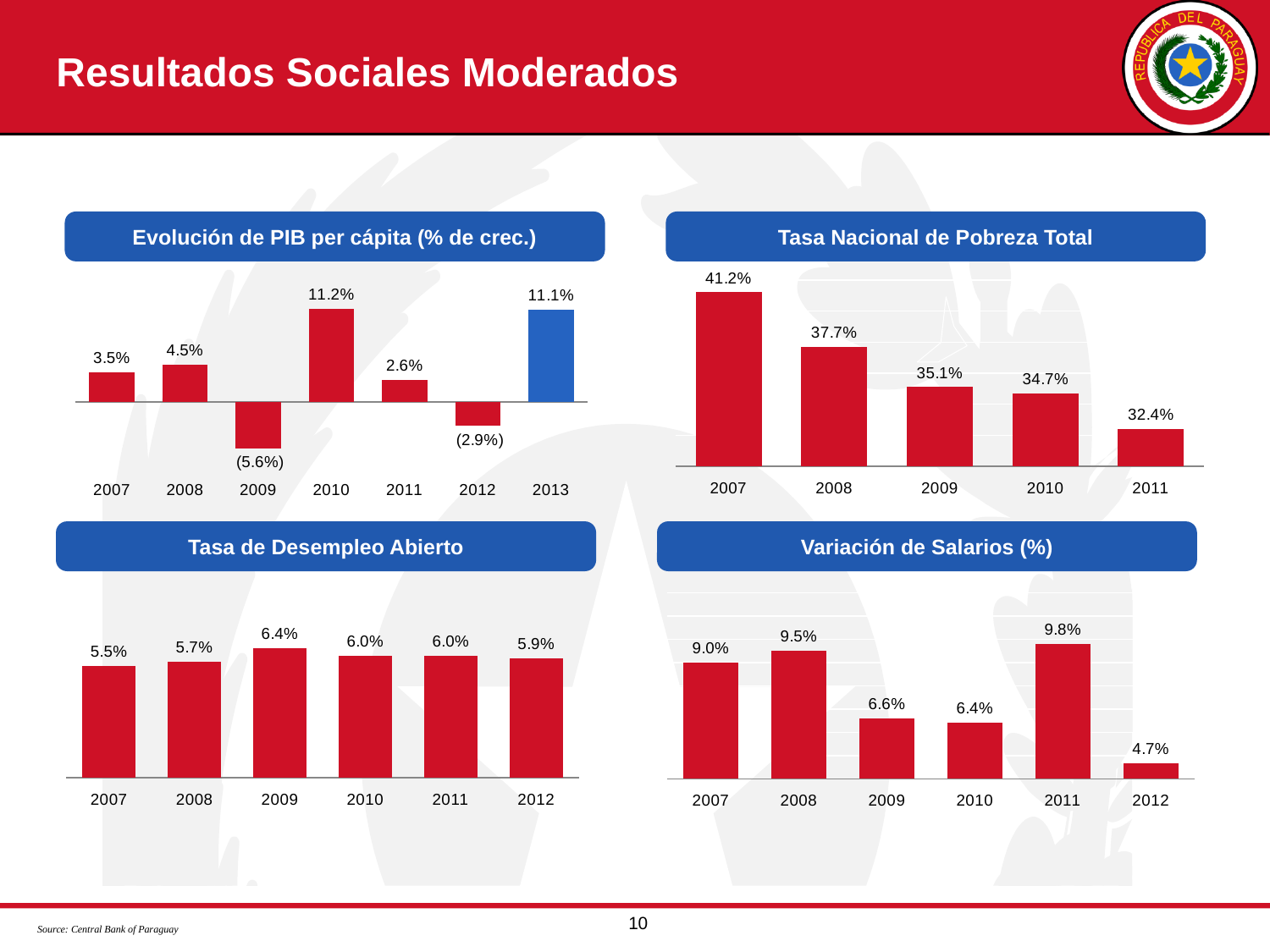
In the 'Tasa Nacional de Pobreza Total' chart, do the values rise or fall from 2007 to 2011? fall In the 'Evolución de PIB per cápita (% de crec.)' chart, which year's bar is coloured blue instead of red? 2013 In the 'Evolución de PIB per cápita (% de crec.)' chart, what is the value for 2010? 11.2% In the 'Tasa Nacional de Pobreza Total' chart, what is the value for 2009? 35.1% What kind of chart is the 'Variación de Salarios (%)' chart? bar chart In the 'Variación de Salarios (%)' chart, which year has the lowest value? 2012 In the 'Evolución de PIB per cápita (% de crec.)' chart, how many years are shown? 7 In the 'Evolución de PIB per cápita (% de crec.)' chart, which year has the lowest value? 2009 In the 'Variación de Salarios (%)' chart, which is larger, the value for 2008 or the value for 2011? 2011 In the 'Tasa de Desempleo Abierto' chart, which year has the highest value? 2009 In the 'Tasa Nacional de Pobreza Total' chart, what is the difference between the 2007 and 2011 values? 8.8 percentage points In the 'Tasa de Desempleo Abierto' chart, what is the value for 2012? 5.9%